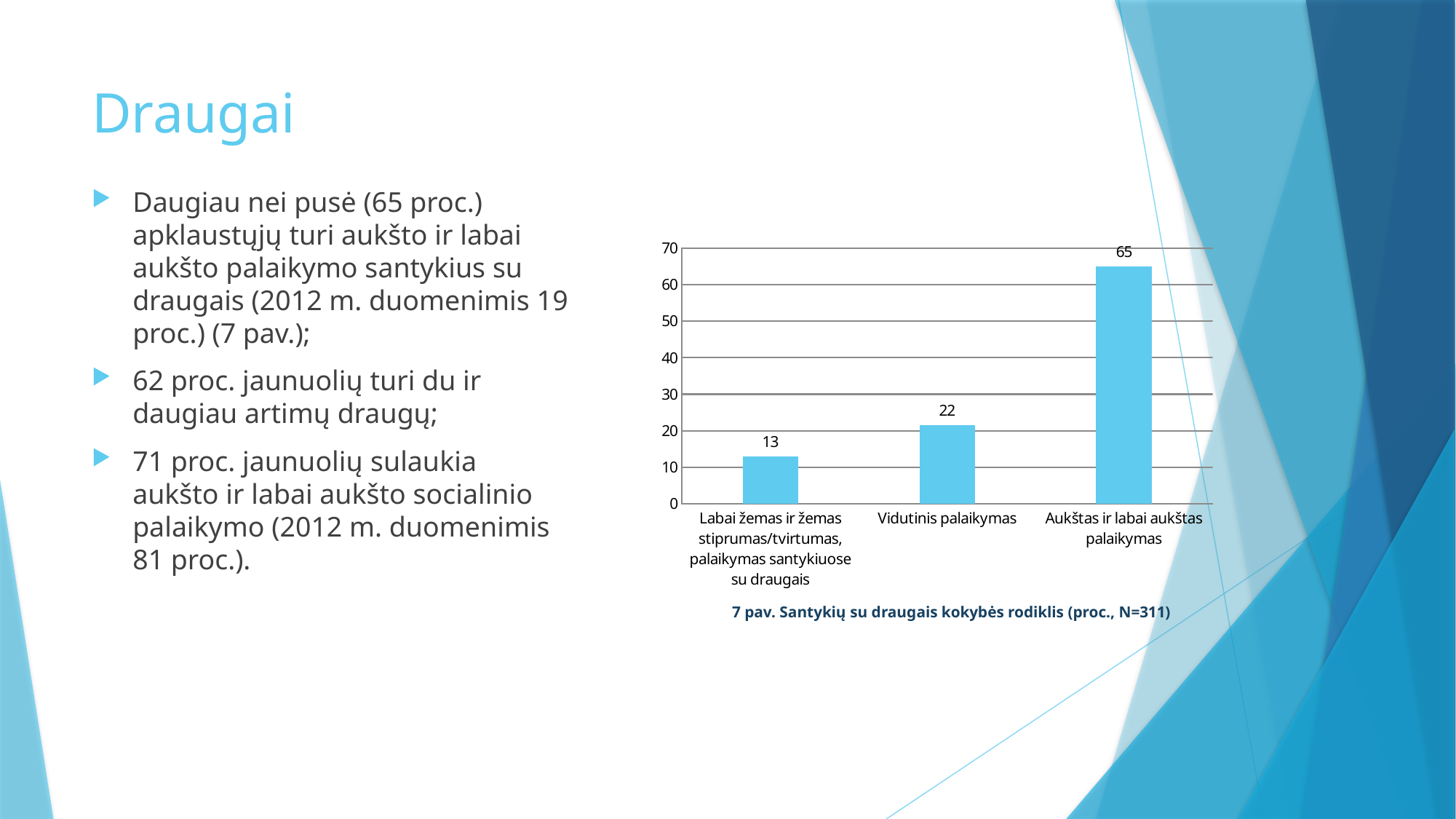
What is the value for "Vidutinis palaikymas"? 22 What is the value for "Labai žemas ir žemas stiprumas/tvirtumas, palaikymas santykiuose su draugais"? 13 What is the value for "Aukštas ir labai aukštas palaikymas"? 65 Which category has the lowest value? Labai žemas ir žemas stiprumas/tvirtumas, palaikymas santykiuose su draugais Which is larger, the value for "Vidutinis palaikymas" or the value for "Labai žemas ir žemas stiprumas/tvirtumas, palaikymas santykiuose su draugais"? Vidutinis palaikymas What is the difference between the values for "Aukštas ir labai aukštas palaikymas" and "Vidutinis palaikymas"? 43 What kind of chart is shown on the slide? bar chart Which category has the highest value? Aukštas ir labai aukštas palaikymas What is the difference between the values for "Vidutinis palaikymas" and "Labai žemas ir žemas stiprumas/tvirtumas, palaikymas santykiuose su draugais"? 9 How many categories are shown in the chart? 3 Is the value for "Aukštas ir labai aukštas palaikymas" greater or less than 60? greater What is the caption of the chart? 7 pav. Santykių su draugais kokybės rodiklis (proc., N=311)